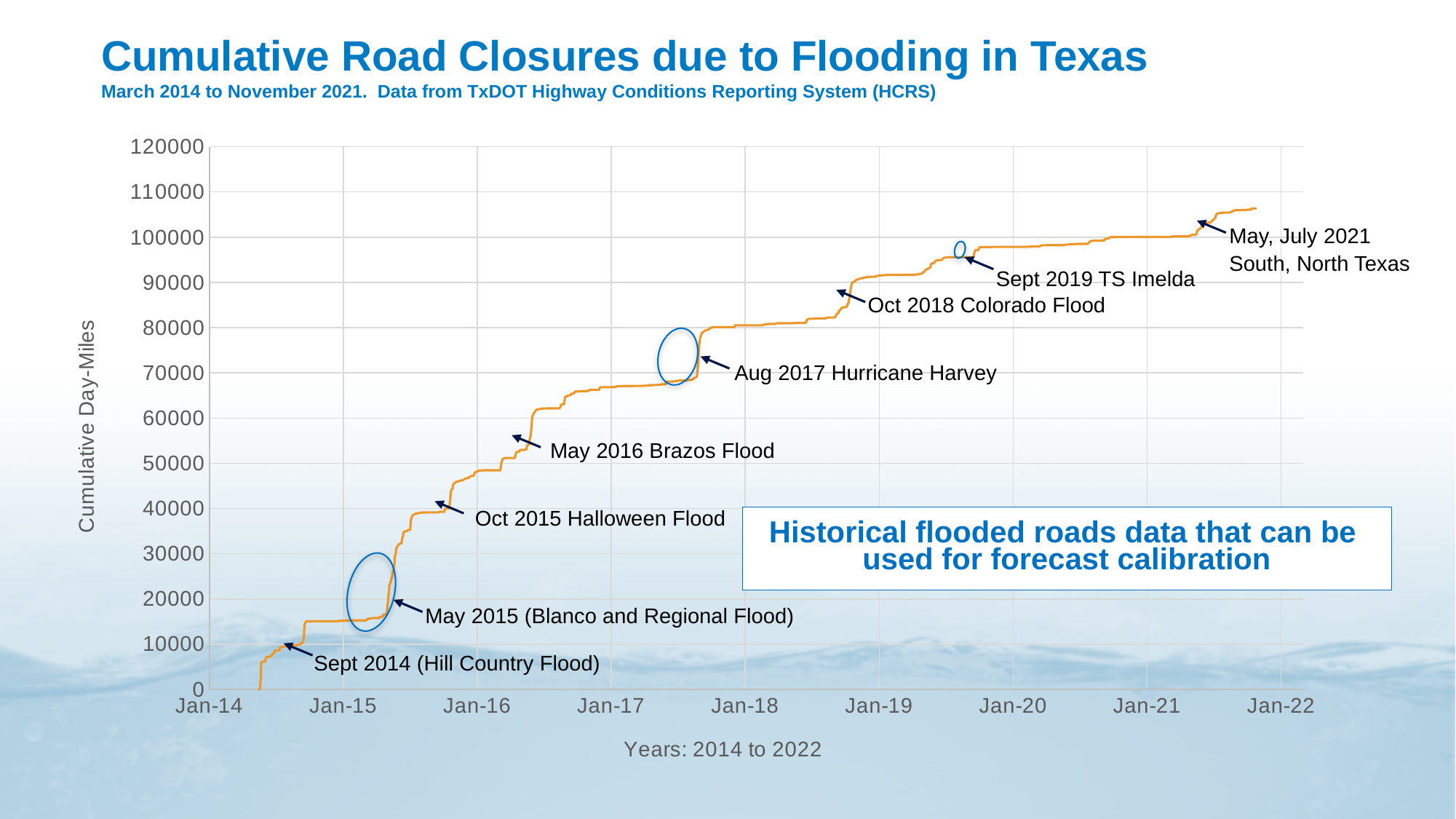
Is the cumulative day-miles value at Jan-15 greater or less than 20000? less What is the label of the y axis? Cumulative Day-Miles Does the cumulative day-miles value rise or fall along the x axis from Jan-14 to Jan-22? rise Which is larger, the cumulative day-miles value at Jan-16 or at Jan-18? Jan-18 Is the cumulative day-miles value at Jan-20 greater or less than 100000? less Is the cumulative day-miles value at Jan-16 greater or less than 30000? greater What kind of chart is shown on the slide? line chart Which flood event is annotated in Aug 2017? Hurricane Harvey